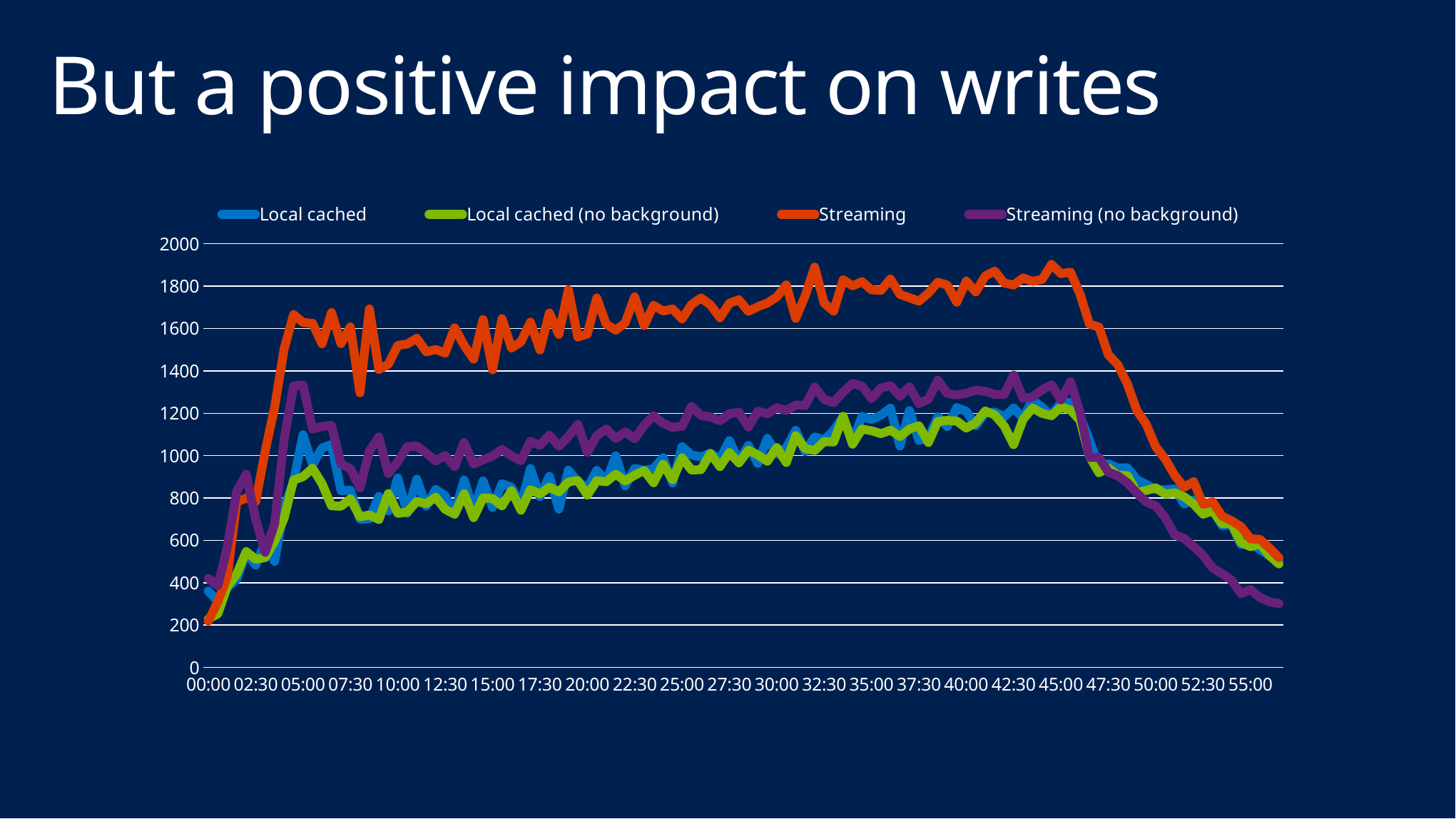
Is the value for Streaming (no background) at 40:00 greater or less than 1000? greater What is the title of the slide containing the chart? But a positive impact on writes At 40:00, which is larger: Streaming or Local cached? Streaming Is the value for Streaming at 30:00 greater or less than 1400? greater Is the value for Local cached at 10:00 greater or less than 1000? less Does the Local cached (no background) series generally rise or fall between 20:00 and 45:00? rise What are the series names listed in the legend? Local cached, Local cached (no background), Streaming, Streaming (no background) What kind of chart is shown on the slide? line chart Does the Streaming series rise or fall between 45:00 and 55:00? fall Which series has the highest values across most of the chart? Streaming How many series does the legend list? 4